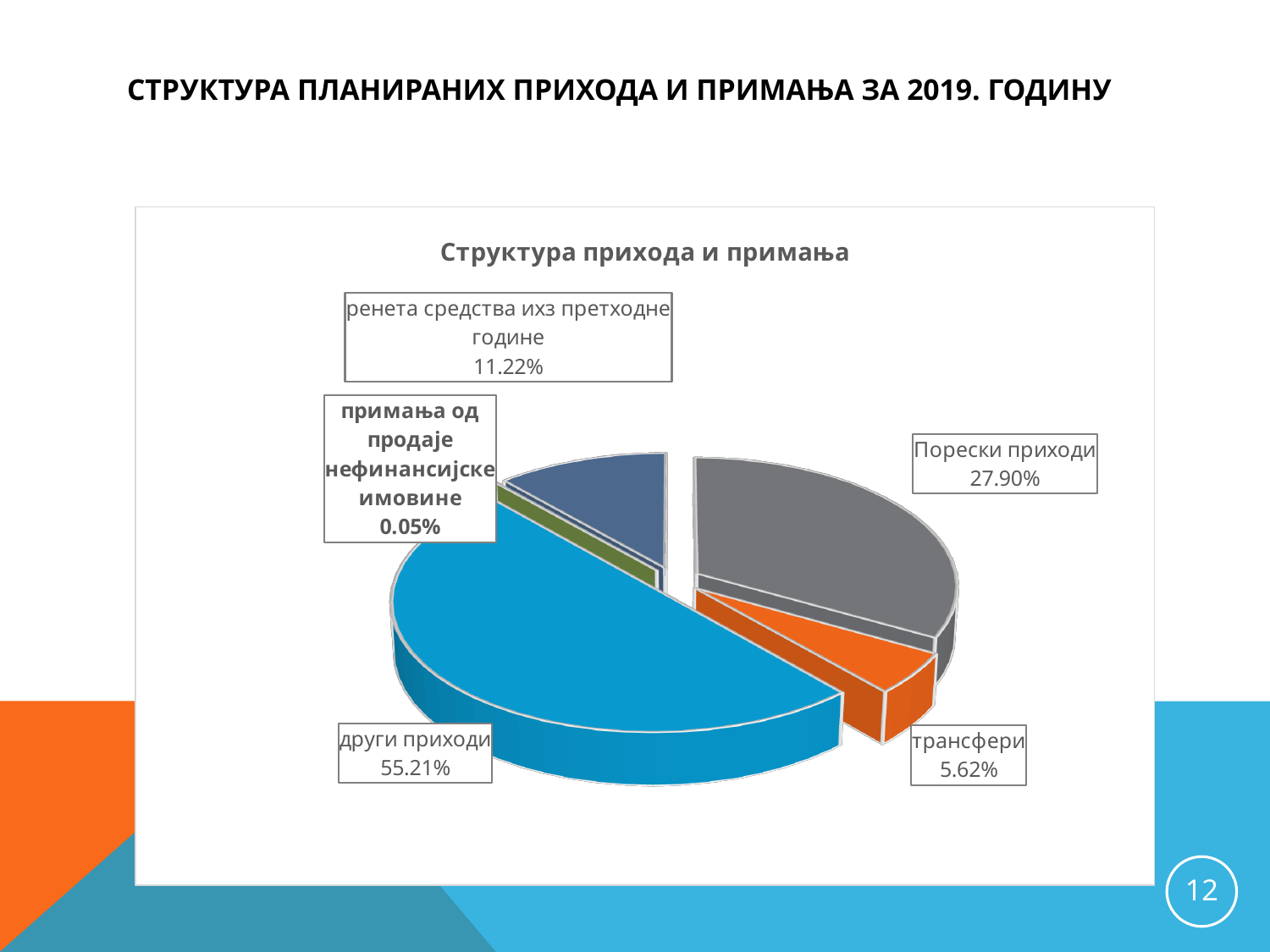
What percentage is shown for the slice labelled 'ренета средства ихз претходне године'? 11.22% Which slice of the pie is the smallest? примања од продаје нефинансијске имовине What share of the pie is labelled 'примања од продаје нефинансијске имовине'? 0.05% How many slices does the pie chart have? 5 Which is larger, the share for 'Порески приходи' or the share for 'трансфери'? Порески приходи Which slice of the pie is the largest? други приходи What share of the pie is labelled 'Порески приходи'? 27.90% What is the title of the chart? Структура прихода и примања What share of the pie is labelled 'трансфери'? 5.62% What is the difference between the shares of 'други приходи' and 'Порески приходи'? 27.31% What share of the pie is labelled 'други приходи'? 55.21% What kind of chart is shown on the slide? Pie chart